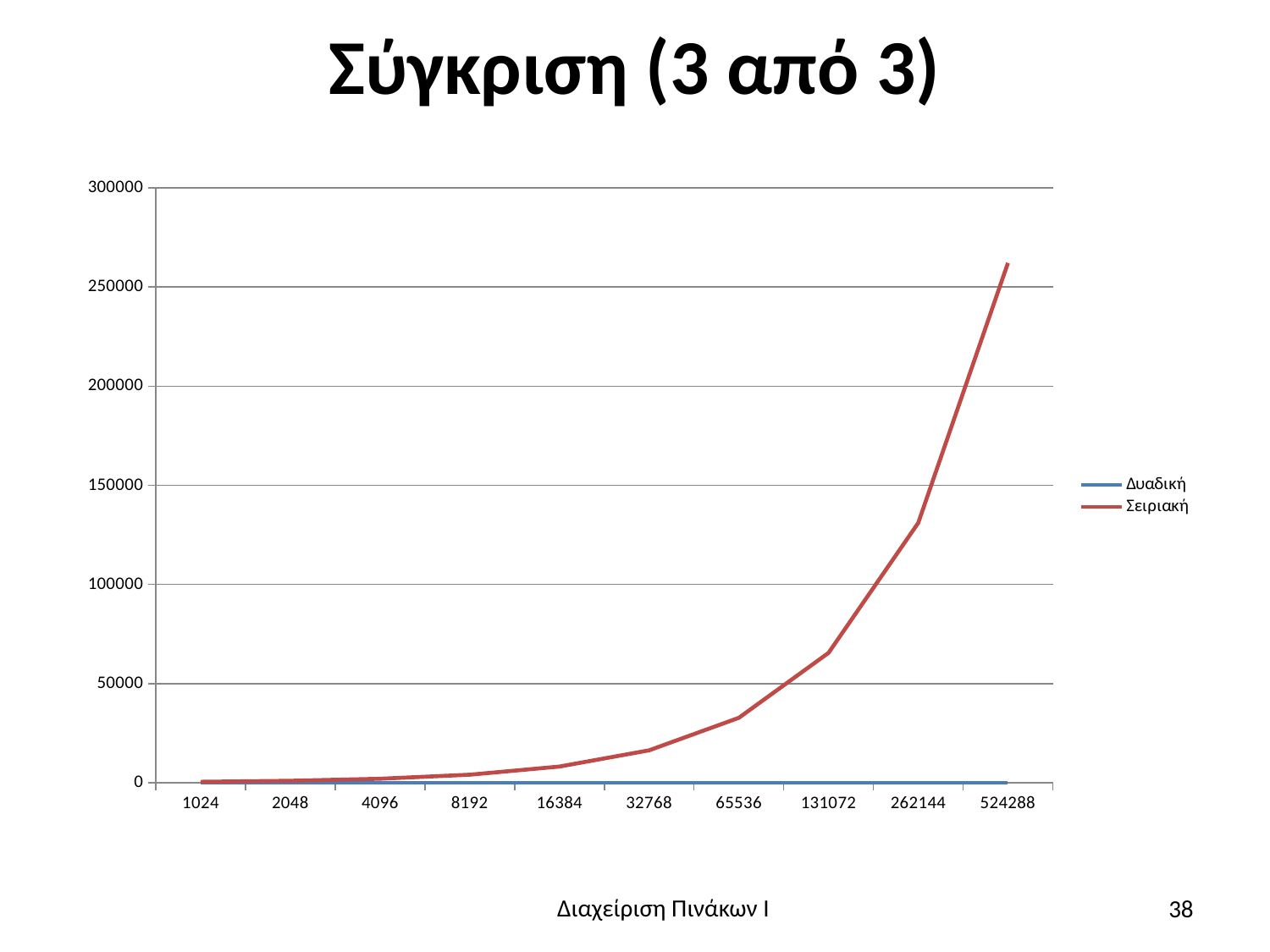
Does the Σειριακή series rise or fall as the x axis goes from 1024 to 524288? rise At which x-axis value does the Σειριακή series reach its highest point? 524288 Is the value of Σειριακή at 65536 greater or less than 50000? less What is the title of the slide containing the chart? Σύγκριση (3 από 3) Which series is drawn in red? Σειριακή Is the value of Σειριακή at 524288 greater or less than 200000? greater How many series does the legend list? 2 How many points are plotted along the x axis for each series? 10 What kind of chart is shown on the slide? line chart Is the value of Σειριακή at 262144 greater or less than 100000? greater At x = 524288, which series has the larger value, Δυαδική or Σειριακή? Σειριακή